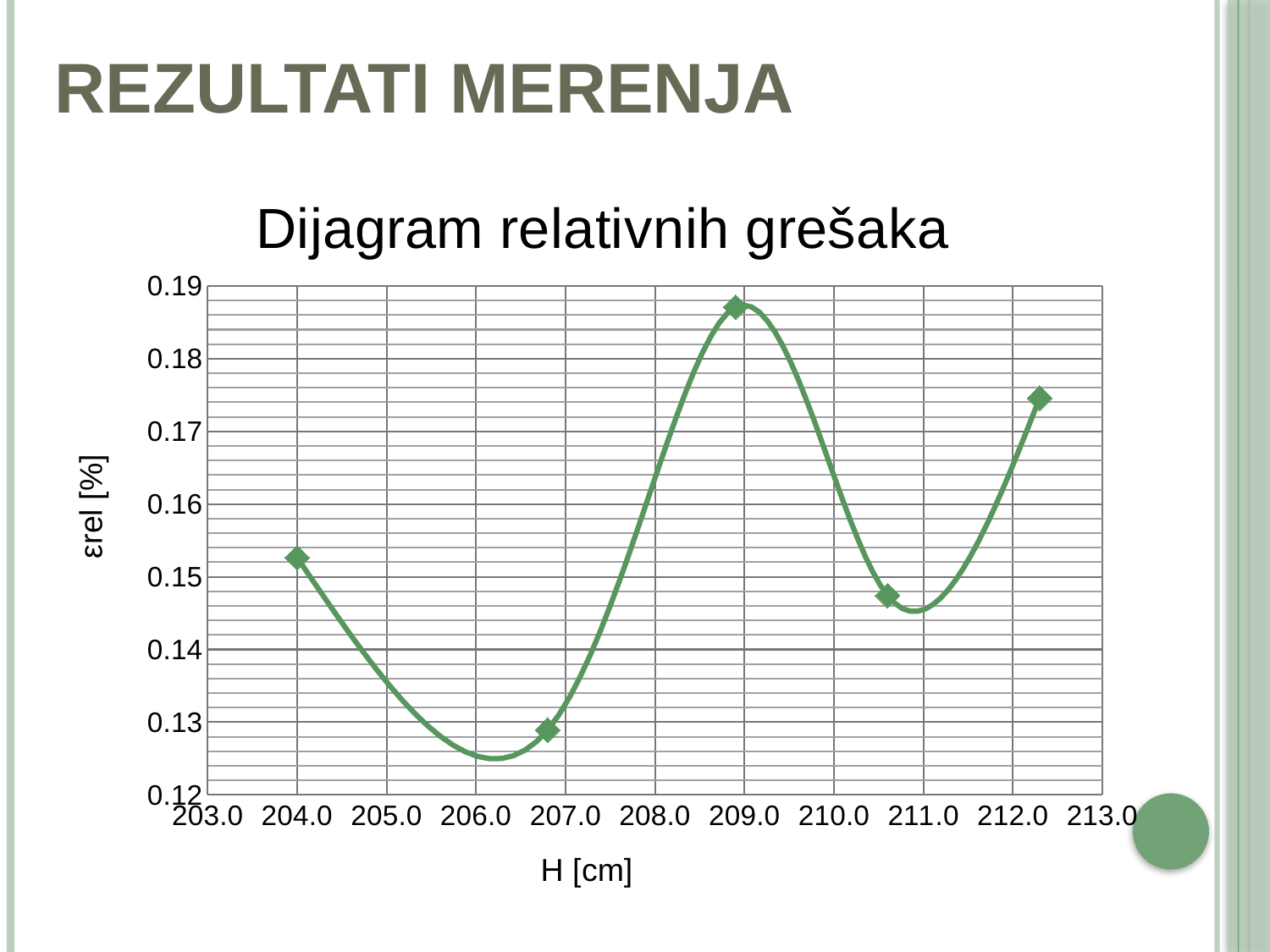
What is the label of the x axis? H [cm] Does the line rise or fall between the second and third points from the left? rises Counting from the left, which point has the lowest value? the second Is the rightmost point on the chart greater or less than 0.17? greater Is the value at H = 204.0 greater or less than 0.15? greater How many data points are plotted on the chart? 5 What is the title of the chart? Dijagram relativnih grešaka Is the highest point on the chart greater or less than 0.18? greater Counting from the left, which point has the highest value? the third Which has the larger value, the first point from the left or the second point from the left? the first point What kind of chart is shown on the slide? line chart